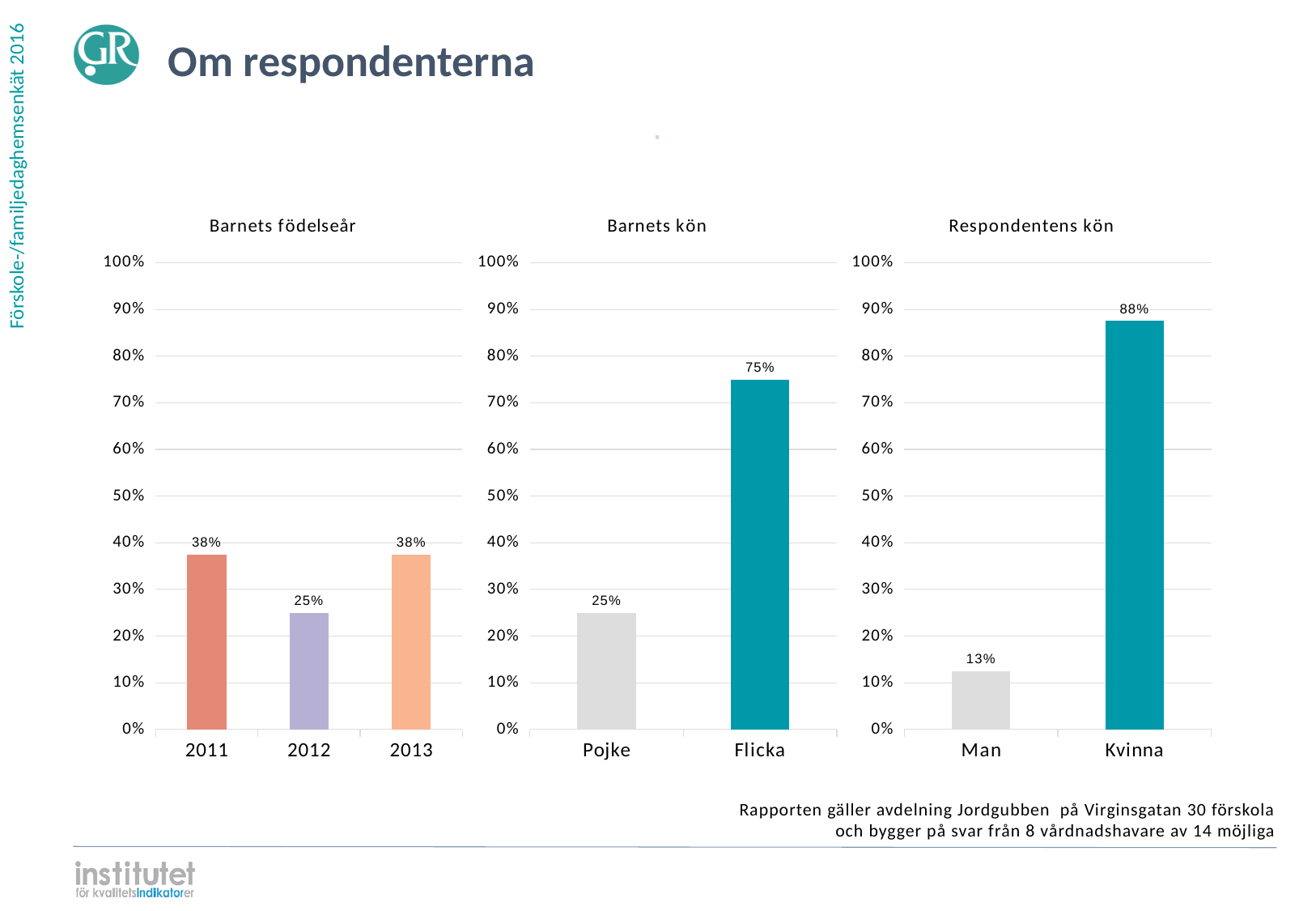
What kind of chart is the 'Barnets kön' chart? Bar chart In the 'Barnets födelseår' chart, what is the value for 2011? 38% In the 'Barnets födelseår' chart, what is the value for 2012? 25% In the 'Respondentens kön' chart, which is larger, Man or Kvinna? Kvinna In the 'Barnets kön' chart, what is the difference between Flicka and Pojke? 50% In the 'Respondentens kön' chart, what is the value for Man? 13% In the 'Barnets födelseår' chart, which year has the lowest value? 2012 In the 'Respondentens kön' chart, is the value for Kvinna greater or less than 80%? greater In the 'Barnets kön' chart, what is the value for Flicka? 75% In the 'Respondentens kön' chart, what is the value for Kvinna? 88% In the 'Barnets födelseår' chart, how many categories are shown on the x axis? 3 In the 'Barnets kön' chart, which category is highest? Flicka